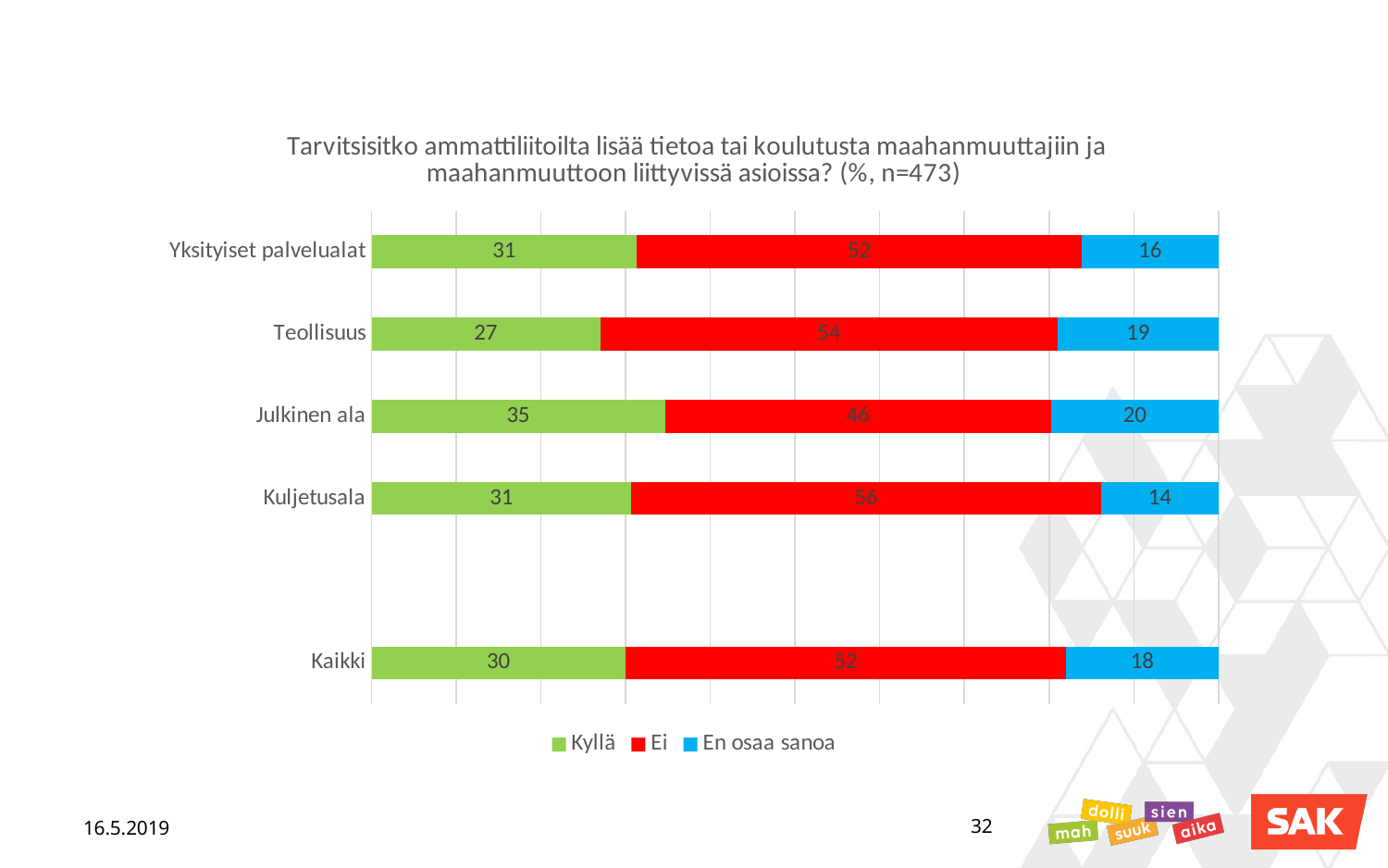
Which is larger, the Kyllä value for Teollisuus or the Kyllä value for Yksityiset palvelualat? Yksityiset palvelualat How many series does the legend list? 3 What is the difference between the Ei values for Kuljetusala and Julkinen ala? 10 Which category has the lowest En osaa sanoa value? Kuljetusala What is the En osaa sanoa value for Teollisuus? 19 Which category has the highest Kyllä value? Julkinen ala What is the Kyllä value for Julkinen ala? 35 How many categories are shown on the chart? 5 What is the Ei value for Kuljetusala? 56 What is the Kyllä value for Kaikki? 30 What is the total of the stacked bar for Yksityiset palvelualat? 99 What kind of chart is shown on the slide? Stacked bar chart